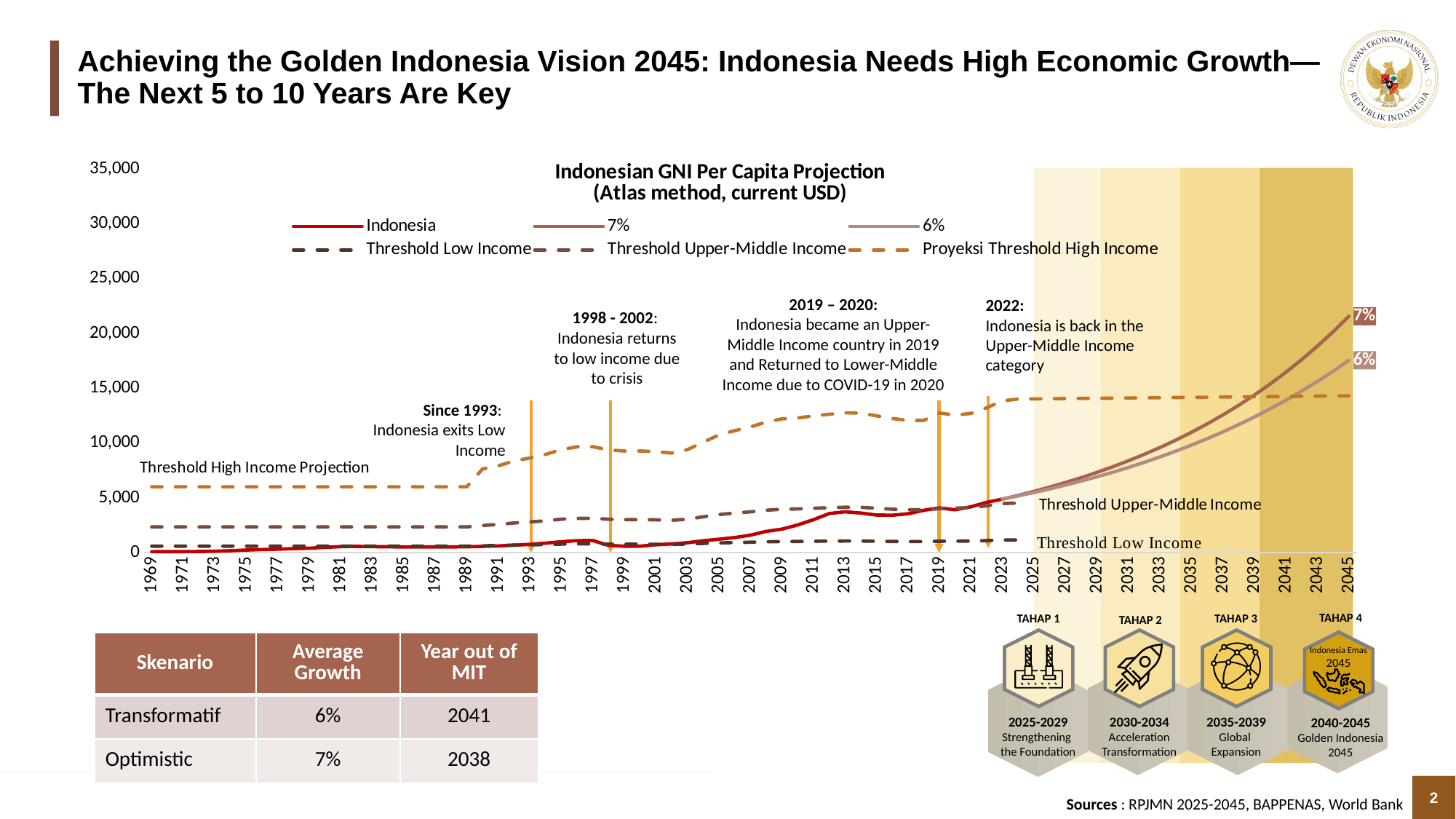
Is the value of the 7% series in 2045 greater or less than 20,000? greater What kind of chart is shown on the slide? line chart What is the title of the chart? Indonesian GNI Per Capita Projection (Atlas method, current USD) Does the Indonesia series generally rise or fall from 1969 to 2023? rise Is the value of the 6% series in 2045 greater or less than 20,000? less How many series does the chart legend list? 6 Which series is higher in 2045, the 7% series or the 6% series? 7% Is the value of the 6% series in 2045 greater or less than 15,000? greater What colour is the Indonesia series line in the chart? red Which is higher in 2045, the 7% series or the Proyeksi Threshold High Income series? 7%